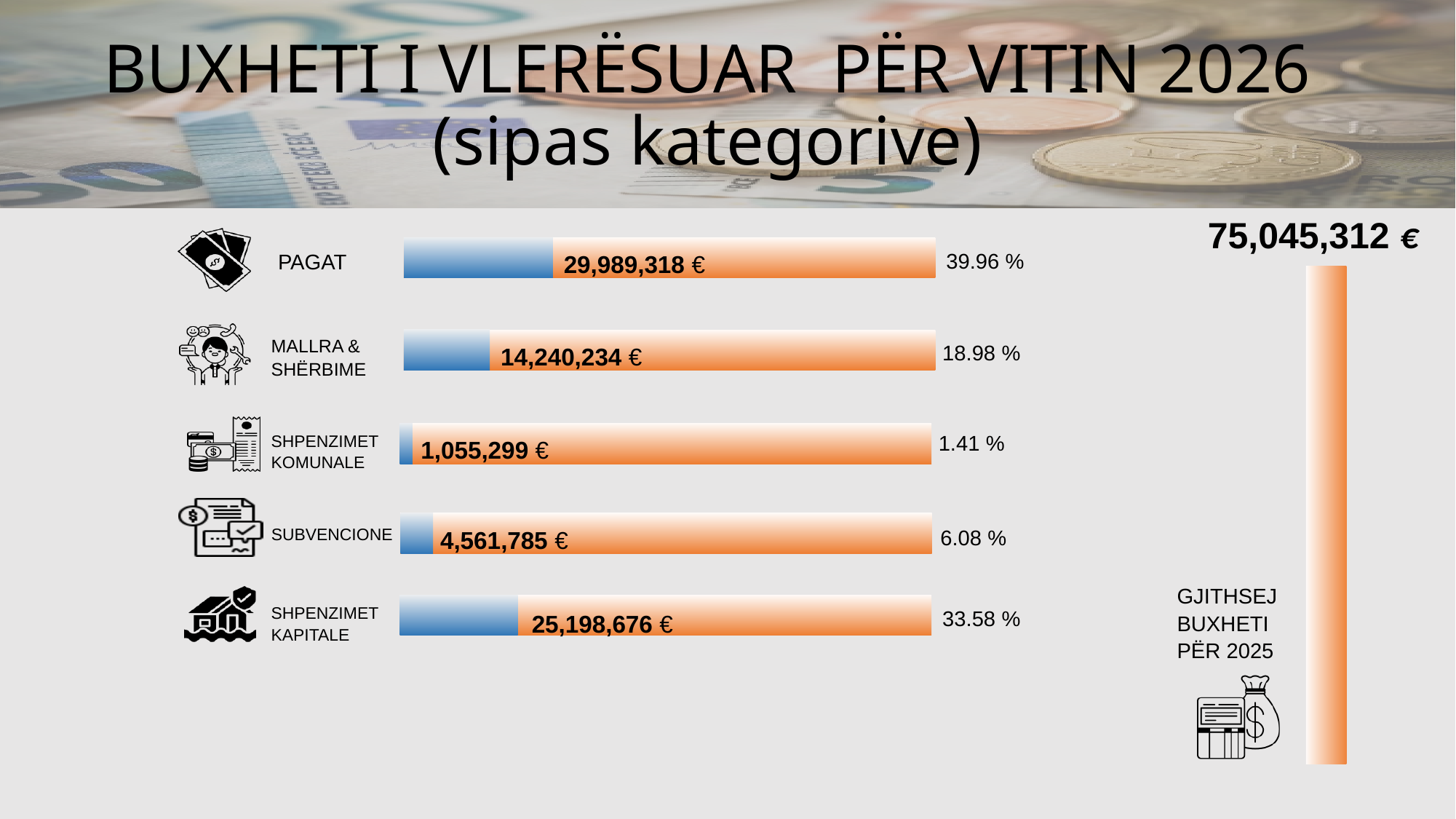
Which is larger, the value for MALLRA & SHËRBIME or the value for SUBVENCIONE? MALLRA & SHËRBIME Which category has the lowest value? SHPENZIMET KOMUNALE Which category has the highest value? PAGAT What percentage is shown for SHPENZIMET KOMUNALE? 1.41 % What kind of chart is shown on the slide? bar chart What is the value for SHPENZIMET KAPITALE? 25,198,676 € What is the value for MALLRA & SHËRBIME? 14,240,234 € What percentage is shown for SUBVENCIONE? 6.08 % What is the total budget shown on the slide? 75,045,312 € How many budget categories are shown in the chart? 5 What is the value for PAGAT? 29,989,318 € What is the difference between the values for PAGAT and SHPENZIMET KAPITALE? 4,790,642 €